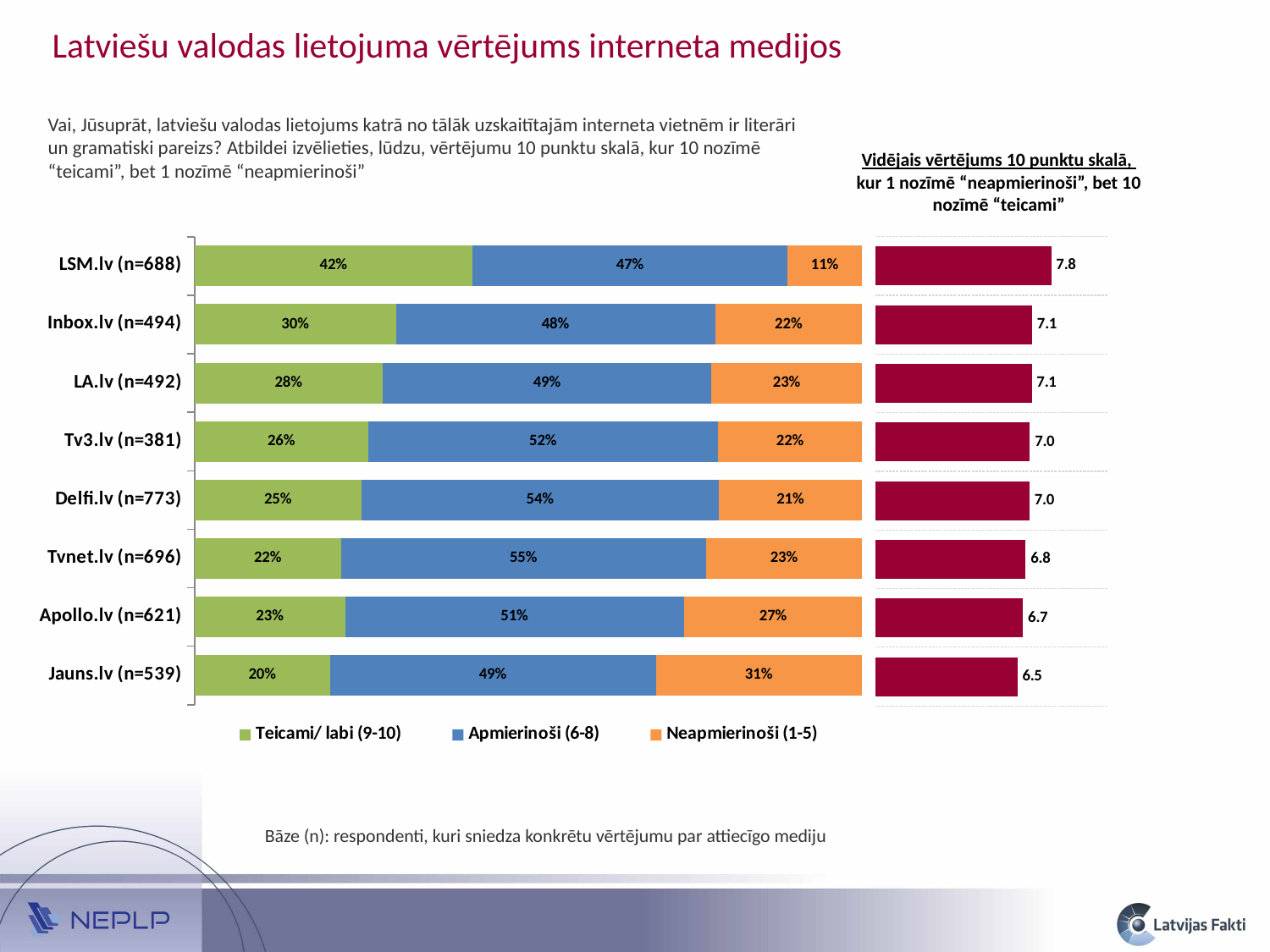
How many series does the legend of the stacked bar chart on the left list? 3 In the stacked bar chart on the left, which site has the lowest Neapmierinoši (1-5) share? LSM.lv (n=688) In the stacked bar chart on the left, which site has the highest Teicami/ labi (9-10) share? LSM.lv (n=688) In the stacked bar chart on the left, what is the Neapmierinoši (1-5) share for Jauns.lv? 31% In the stacked bar chart on the left, which is larger: the Apmierinoši (6-8) share for Tvnet.lv or for Apollo.lv? Tvnet.lv In the stacked bar chart on the left, what is the difference between the Neapmierinoši (1-5) shares of Jauns.lv and LSM.lv? 20 percentage points How many internet sites are shown as categories in the stacked bar chart on the left? 8 In the stacked bar chart on the left, what percentage of LSM.lv respondents rated the language use as Teicami/ labi (9-10)? 42% What type of chart is the chart on the right showing the average rating on a 10-point scale? Bar chart In the bar chart on the right showing the average rating on a 10-point scale, what is the value for LSM.lv? 7.8 In the bar chart on the right showing the average rating on a 10-point scale, which site has the lowest average? Jauns.lv (n=539) In the stacked bar chart on the left, what is the Apmierinoši (6-8) value for Delfi.lv? 54%